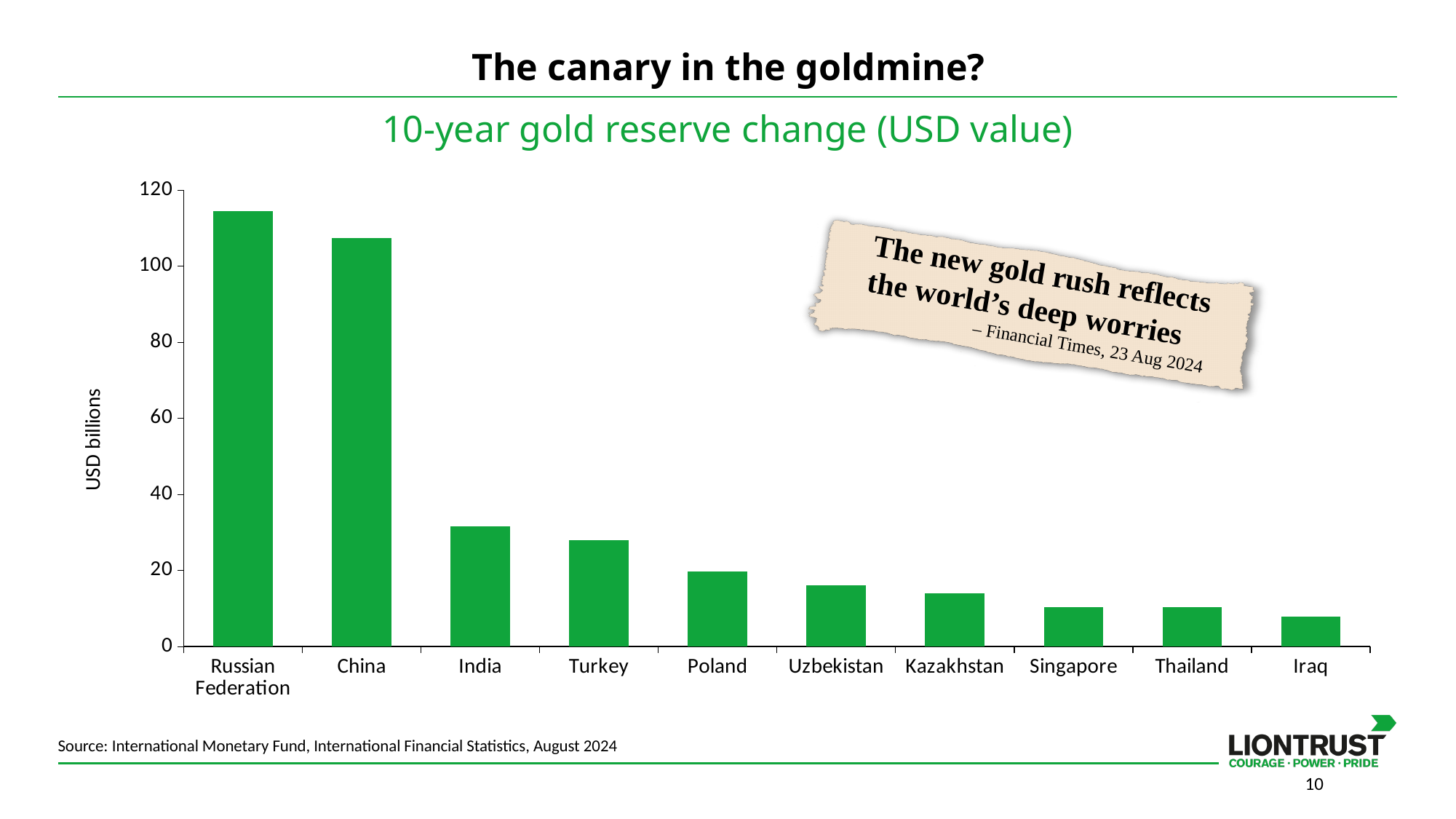
Which is larger, the value for India or the value for Poland? India What is the label on the vertical axis of the chart? USD billions Which country has the lowest 10-year gold reserve change? Iraq Is the value for India greater or less than 40? less Do the values rise or fall moving from left to right along the x axis? fall How many countries are shown on the chart? 10 Which country has the highest 10-year gold reserve change? Russian Federation Is the value for Turkey greater or less than 20? greater Is the value for Uzbekistan greater or less than 20? less What kind of chart is shown on the slide? bar chart What is the title of the chart? 10-year gold reserve change (USD value)